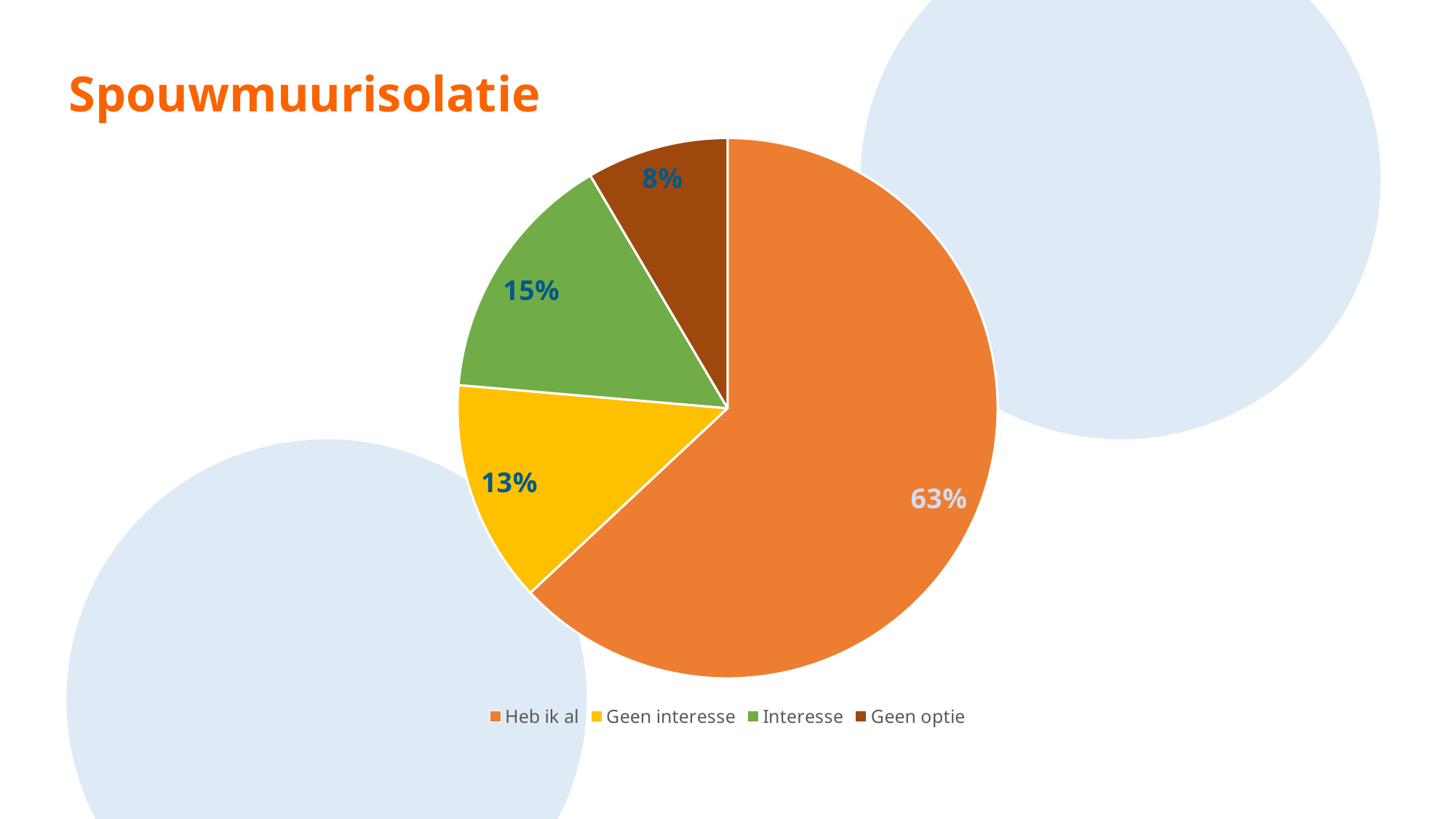
Which is larger, "Interesse" or "Geen interesse"? Interesse How many slices does the pie chart have? 4 Which category has the smallest slice of the pie? Geen optie What colour is the "Geen interesse" slice? yellow What percentage is shown for "Interesse"? 15% What percentage is shown for "Geen optie"? 8% What is the title of the slide? Spouwmuurisolatie Which category has the largest slice of the pie? Heb ik al What is the difference in percentage points between "Heb ik al" and "Interesse"? 48 What percentage is shown for "Geen interesse"? 13% What kind of chart is shown on the slide? pie chart What percentage is shown for "Heb ik al"? 63%